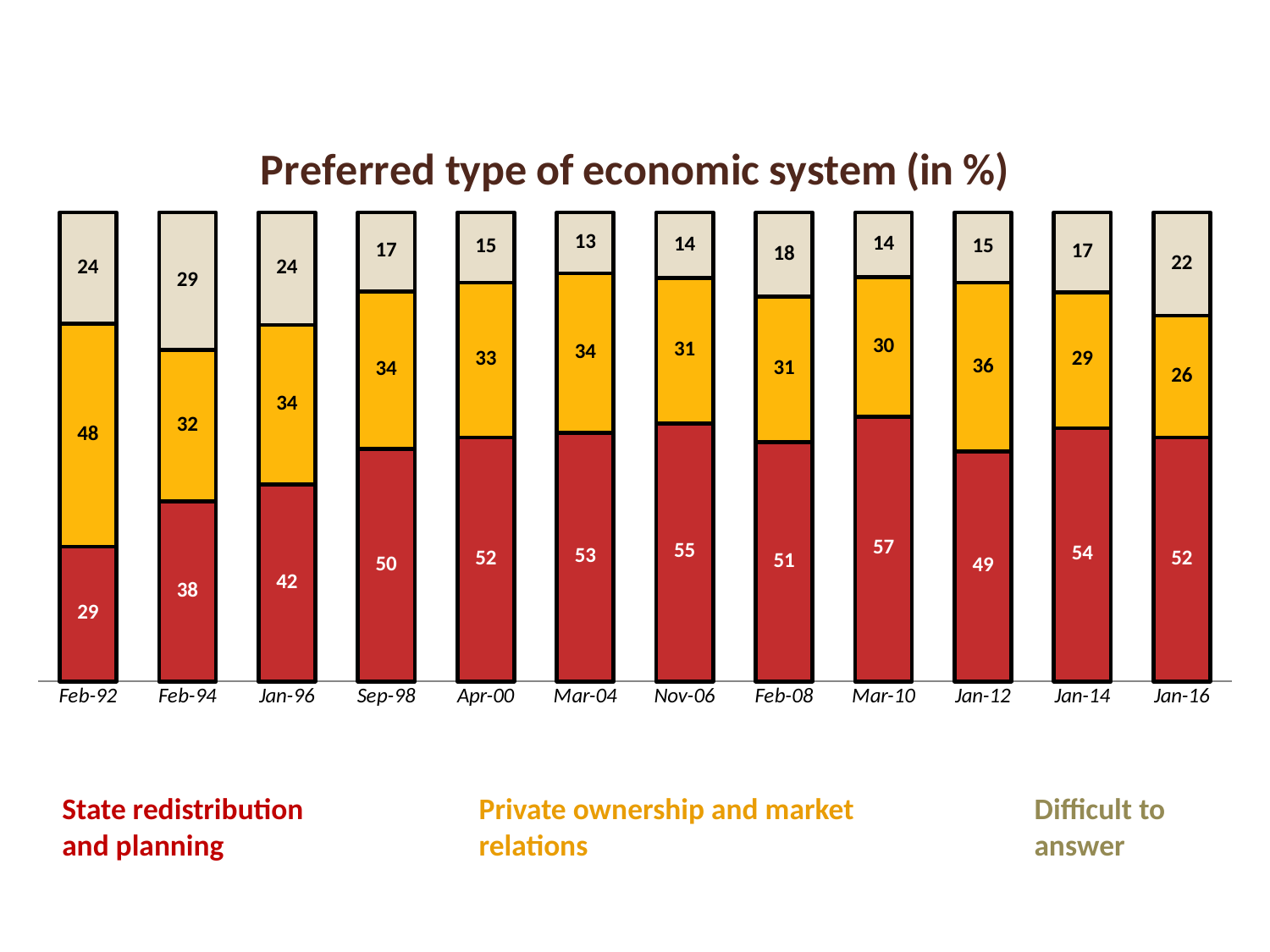
How many time periods are shown on the x axis? 12 What is the title of the chart? Preferred type of economic system (in %) Which is larger in Feb-92: State redistribution and planning or Private ownership and market relations? Private ownership and market relations What is the value for Private ownership and market relations in Jan-12? 36 Does the value for State redistribution and planning rise or fall from Feb-92 to Sep-98? Rise In which period is the value for Private ownership and market relations lowest? Jan-16 What is the value for State redistribution and planning in Feb-92? 29 In which period is the value for State redistribution and planning highest? Mar-10 What is the difference between the State redistribution and planning values in Mar-10 and Feb-92? 28 What is the value for Difficult to answer in Jan-16? 22 How many series does the chart show? 3 What kind of chart is this? Stacked bar chart